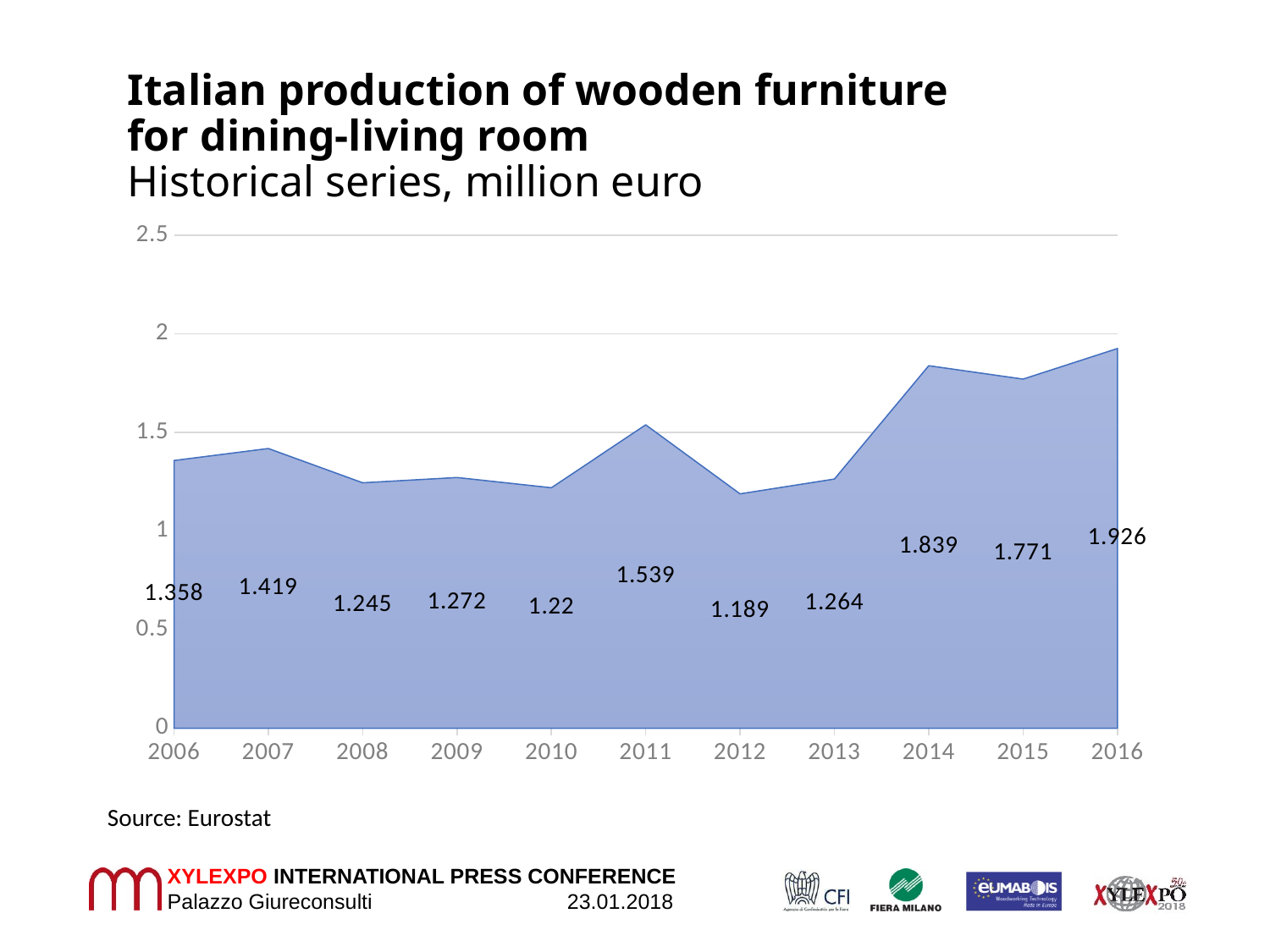
What is the difference between the values for 2014 and 2013? 0.575 How many years are shown on the x axis? 11 What is the source cited for the chart data? Eurostat What kind of chart is shown on the slide? area chart Which is larger, the value for 2007 or the value for 2008? 2007 Which year has the highest value? 2016 Is the value for 2014 greater or less than 1.5? greater Which year has the lowest value? 2012 What is the value for 2010? 1.22 What is the value for 2016? 1.926 What is the value for 2011? 1.539 What is the difference between the values for 2016 and 2015? 0.155